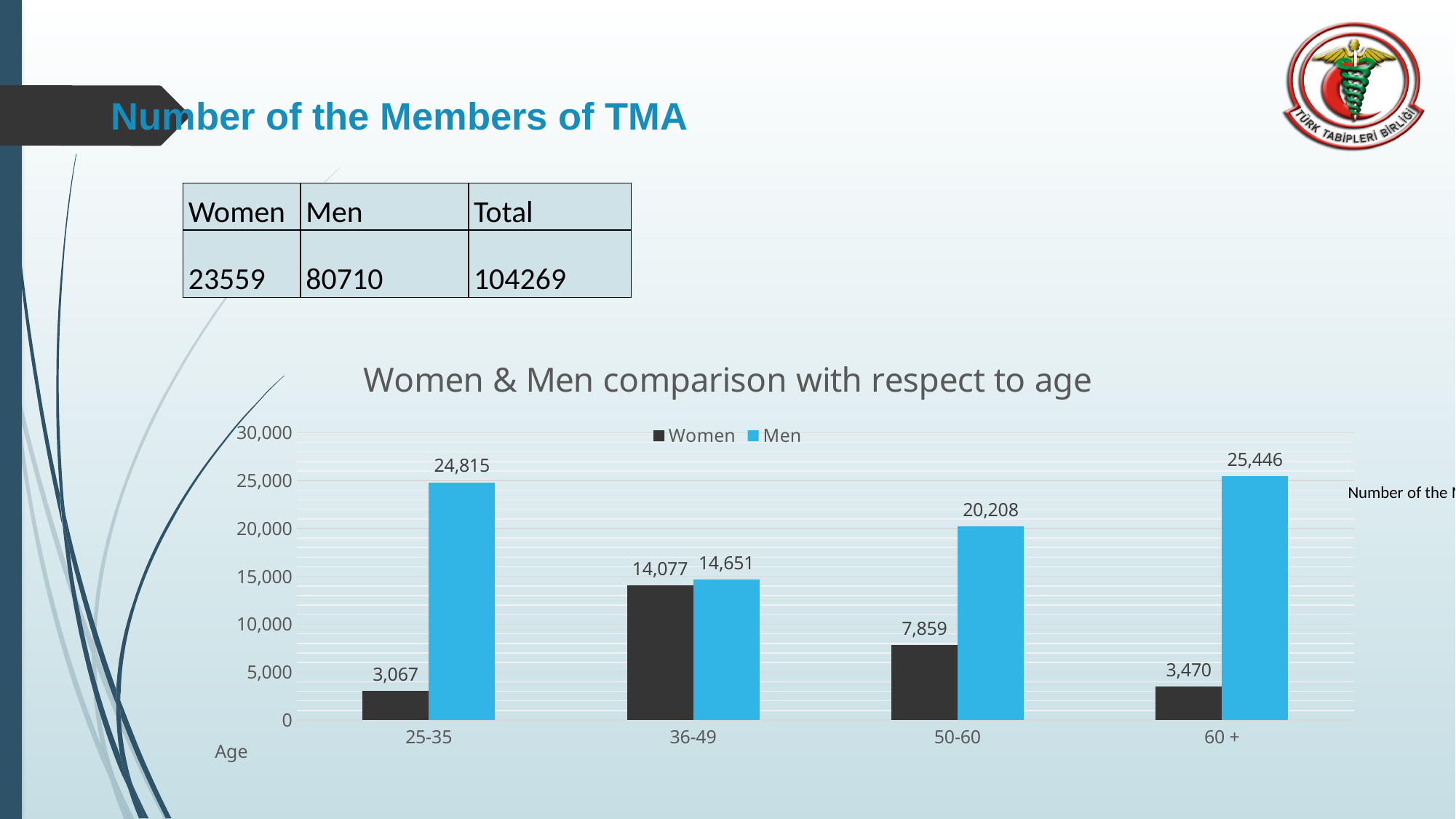
How many age groups are shown on the x axis? 4 What kind of chart is shown on the slide? bar chart What is the difference between Men and Women in the 50-60 age group? 12,349 What is the title of the chart? Women & Men comparison with respect to age Which age group has the highest value for Men? 60 + Is the value for Men in the 25-35 age group greater or less than 20,000? greater What is the value for Women in the 36-49 age group? 14,077 How many series does the legend list? 2 Which is larger in the 36-49 age group, Women or Men? Men What is the value for Men in the 60 + age group? 25,446 Which age group has the lowest value for Women? 25-35 What is the value for Women in the 25-35 age group? 3,067